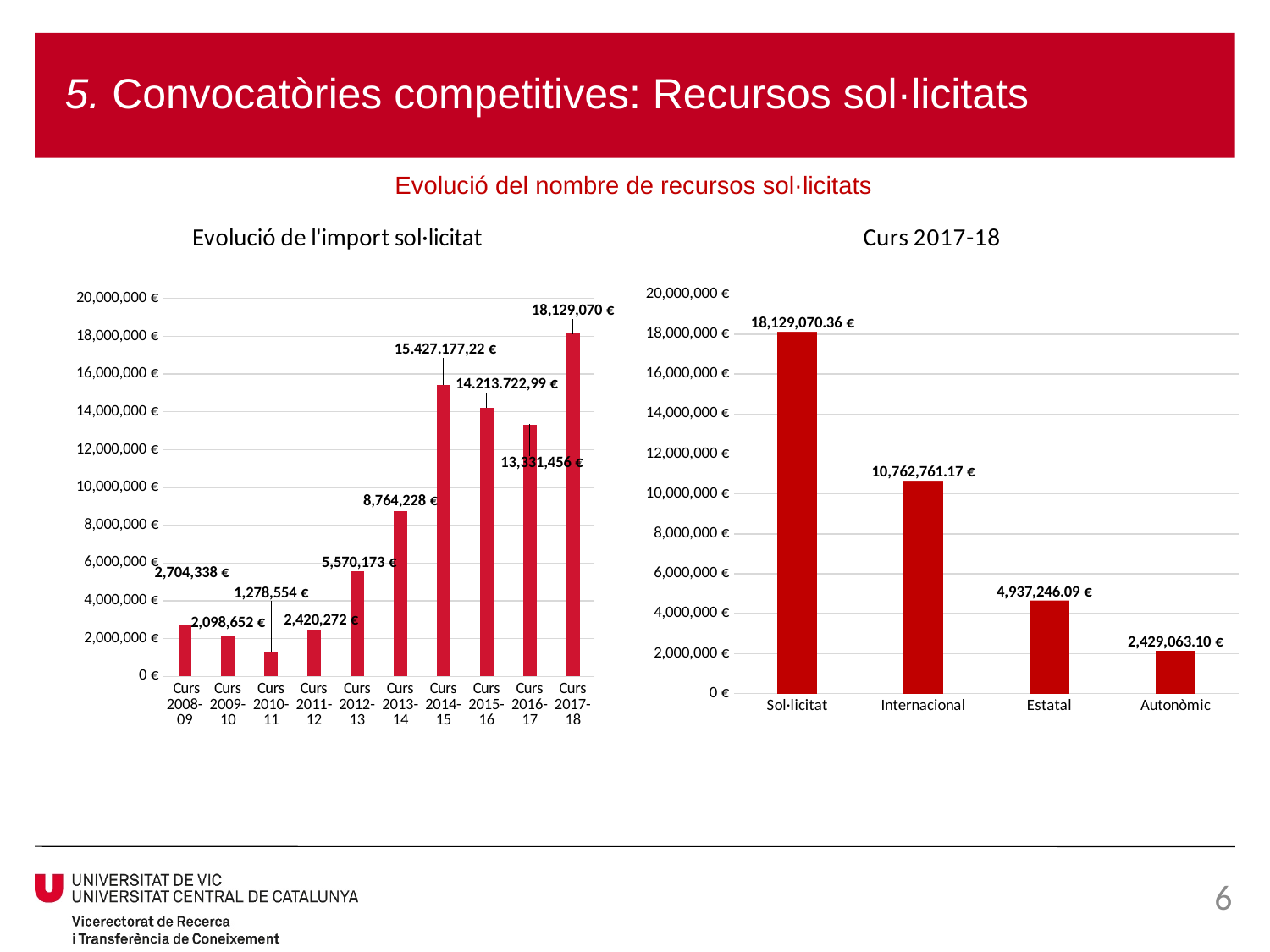
In the chart titled "Curs 2017-18", what is the value for Autonòmic? 2,429,063.10 € In the chart titled "Evolució de l'import sol·licitat", what is the value for Curs 2017-18? 18,129,070 € In the chart titled "Evolució de l'import sol·licitat", which is larger, the value for Curs 2014-15 or the value for Curs 2016-17? Curs 2014-15 In the chart titled "Evolució de l'import sol·licitat", how many categories are shown on the x axis? 10 In the chart titled "Evolució de l'import sol·licitat", which category has the lowest value? Curs 2010-11 What kind of chart is the chart titled "Curs 2017-18"? Bar chart In the chart titled "Curs 2017-18", how many categories are shown on the x axis? 4 In the chart titled "Evolució de l'import sol·licitat", what is the value for Curs 2010-11? 1,278,554 € In the chart titled "Evolució de l'import sol·licitat", is the value for Curs 2013-14 greater or less than 8,000,000 €? greater In the chart titled "Curs 2017-18", what is the value for Internacional? 10,762,761.17 € In the chart titled "Curs 2017-18", which category has the lowest value? Autonòmic In the chart titled "Evolució de l'import sol·licitat", which category has the highest value? Curs 2017-18